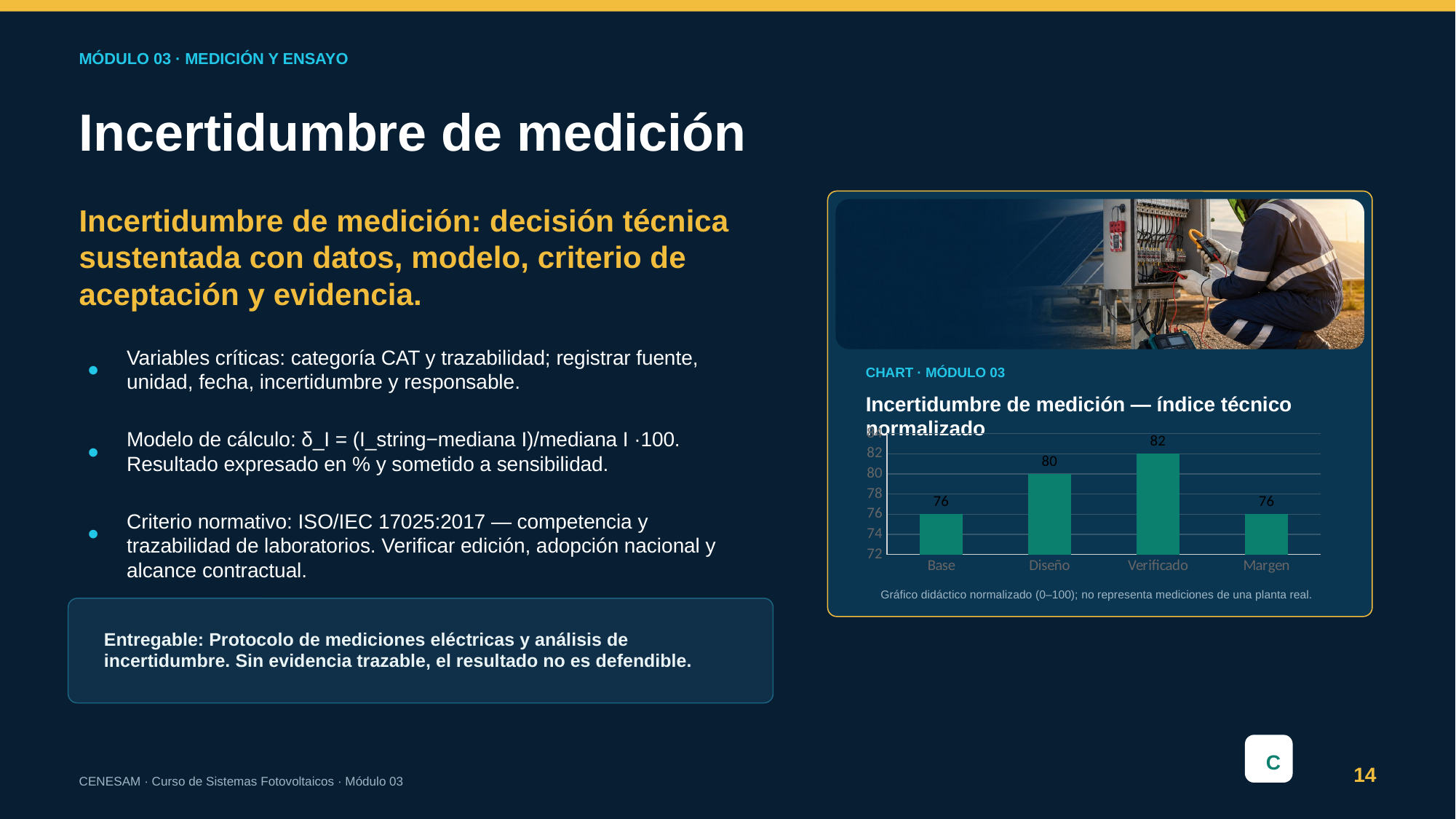
What is the value for Base? 76 Which is larger, the value for Diseño or the value for Verificado? Verificado What kind of chart is shown on the slide? bar chart What is the difference between the values for Verificado and Base? 6 Is the value for Diseño greater or less than 78? greater What is the title of the chart? Incertidumbre de medición — índice técnico normalizado What is the difference between the values for Diseño and Margen? 4 What is the value for Verificado? 82 Which category has the highest value? Verificado What is the value for Margen? 76 How many categories are shown on the x axis? 4 What is the value for Diseño? 80